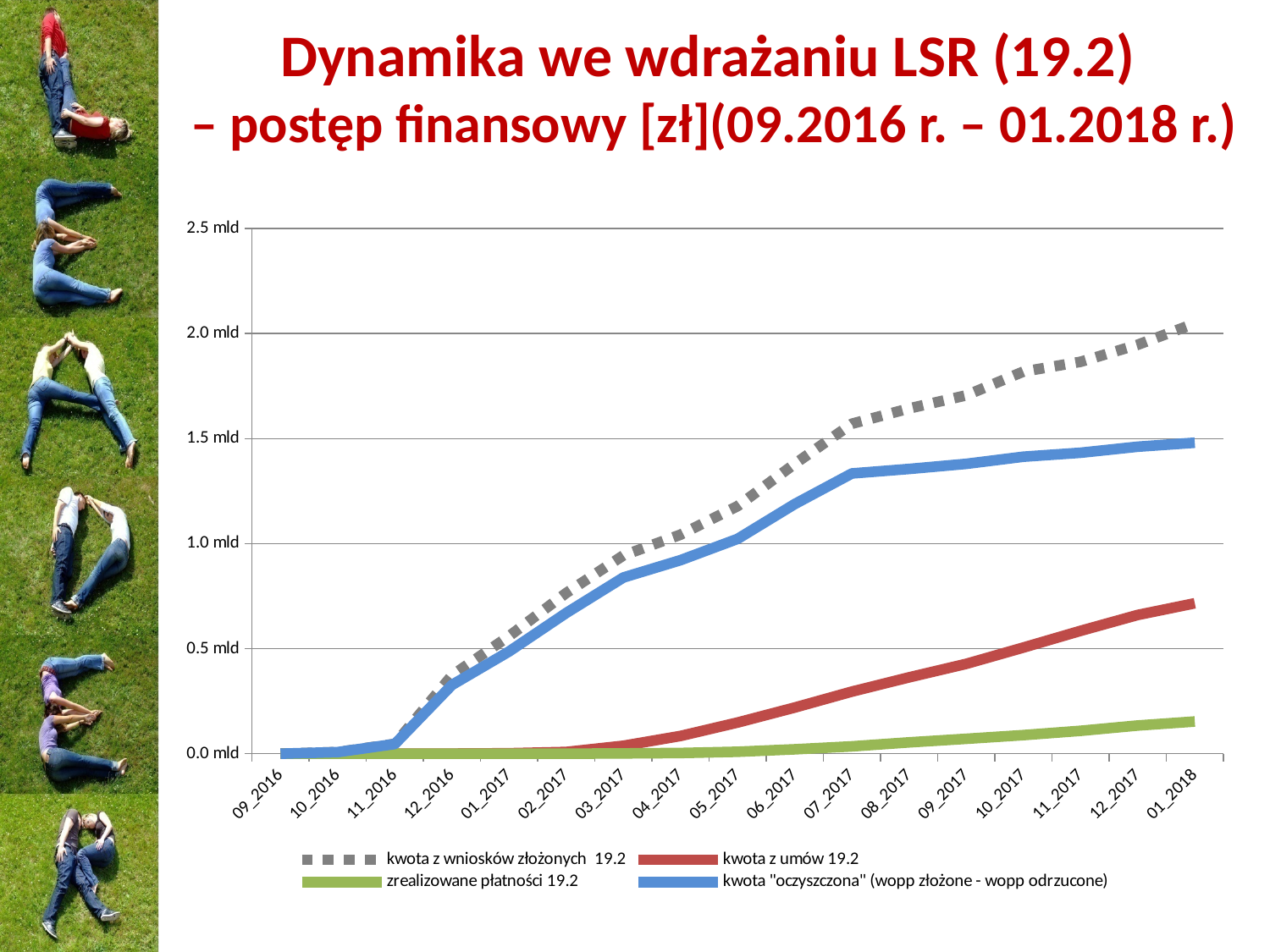
Is the value of "zrealizowane płatności 19.2" at 01_2018 greater or less than 0.5 mld? less How many series does the legend list? 4 At 01_2018, which is larger: "kwota z umów 19.2" or "zrealizowane płatności 19.2"? kwota z umów 19.2 Is the value of "kwota z umów 19.2" at 01_2018 greater or less than 0.5 mld? greater What kind of chart is shown on the slide? line chart Is the value of "kwota "oczyszczona"" at 07_2017 greater or less than 1.0 mld? greater Does the "kwota z wniosków złożonych 19.2" series rise or fall from 09_2016 to 01_2018? rise How many months are shown along the x axis? 17 Which series has the lowest value at 01_2018? zrealizowane płatności 19.2 Which series is drawn as a dotted grey line? kwota z wniosków złożonych 19.2 Which series has the highest value at 01_2018? kwota z wniosków złożonych 19.2